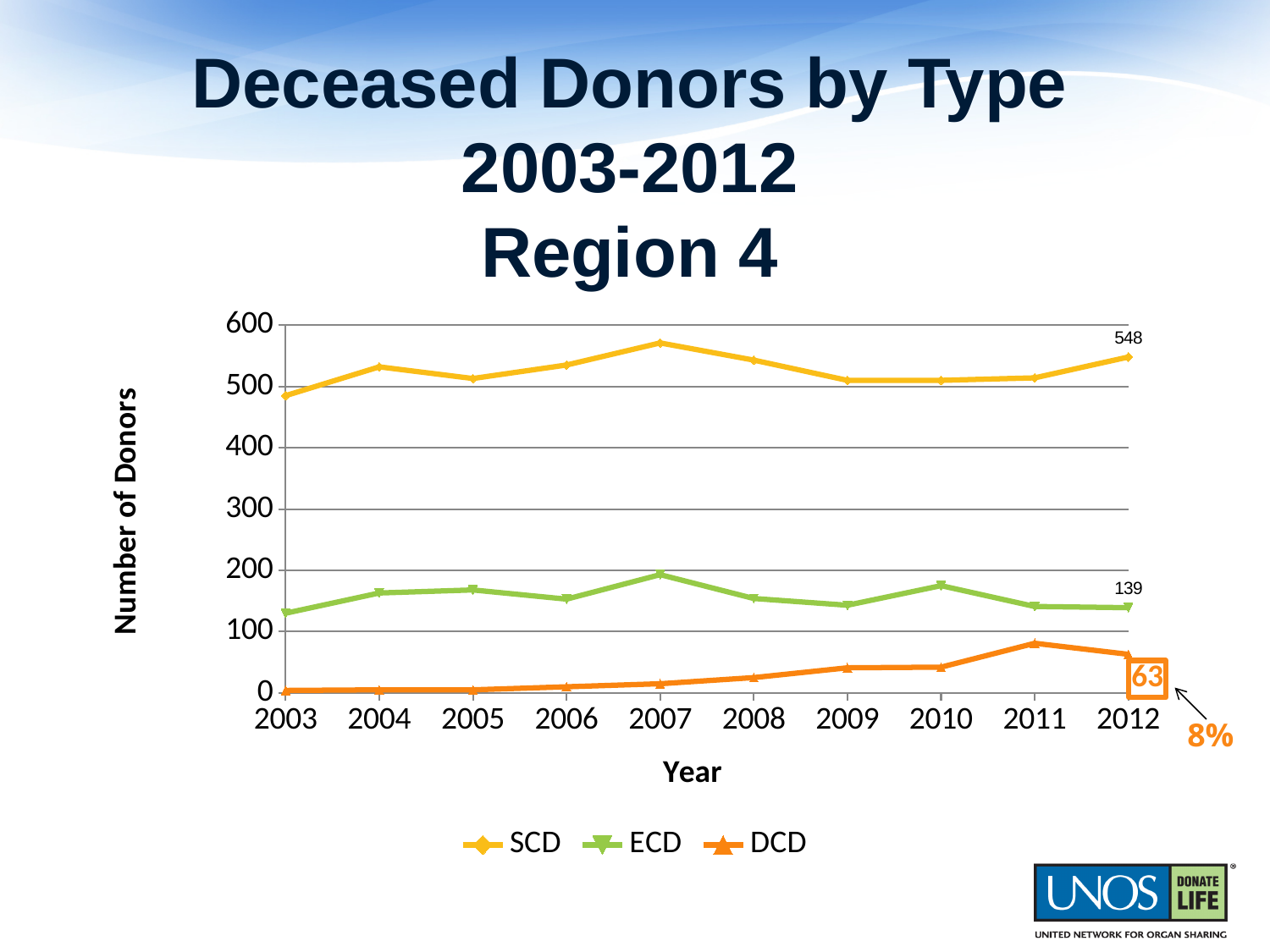
How many series does the legend list? 3 What kind of chart is shown on the slide? line chart What is the value for ECD in 2012? 139 Is the value for SCD in 2003 greater or less than 500? less Which series has the highest value in 2012? SCD How many years are shown on the x axis? 10 In which year does the SCD series reach its highest value? 2007 Is the value for DCD in 2011 greater or less than 100? less What is the value for SCD in 2012? 548 What is the difference between the SCD and ECD values in 2012? 409 What is the value for DCD in 2012? 63 In which year does the DCD series reach its highest value? 2011